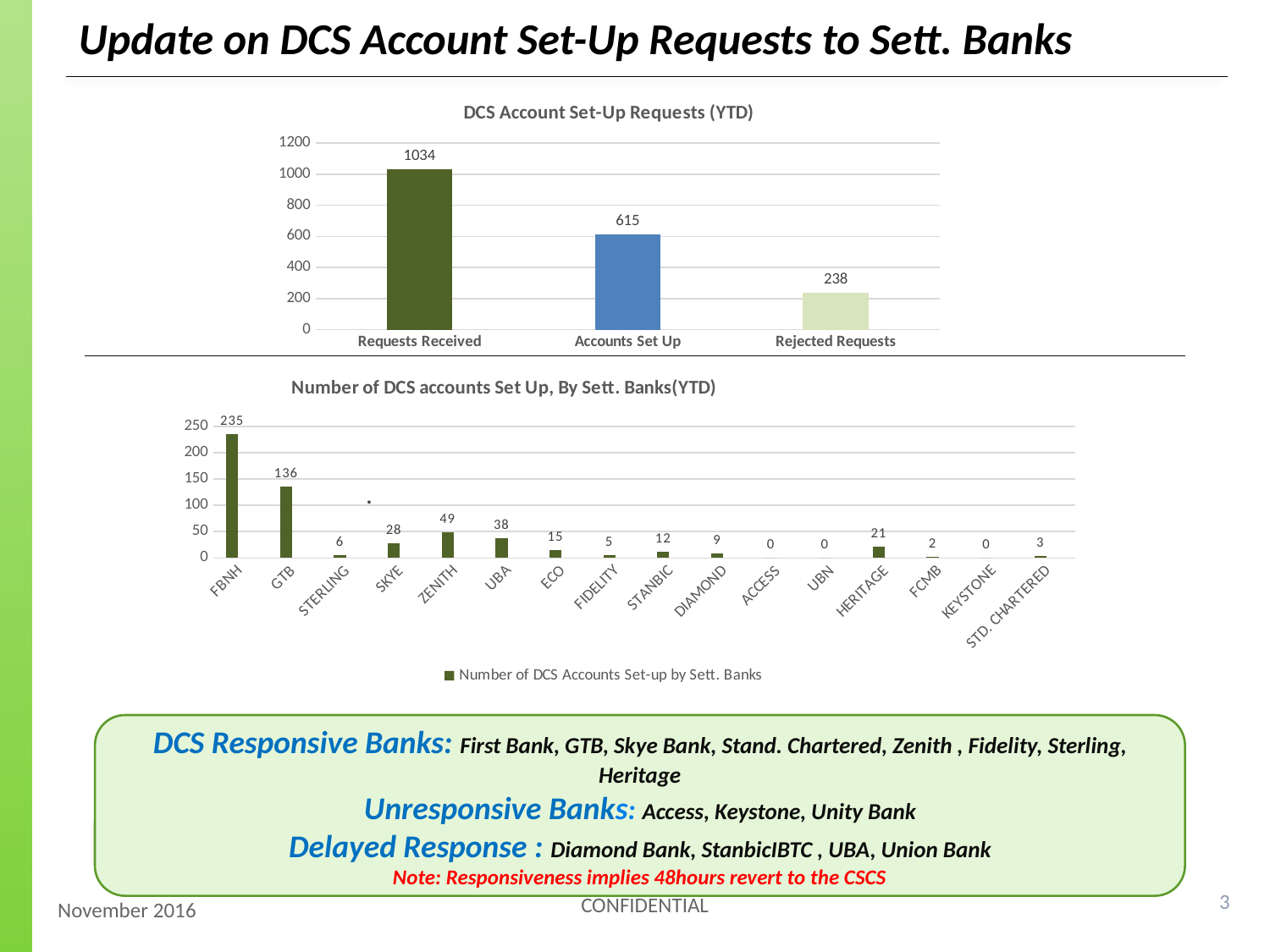
In the 'Number of DCS accounts Set Up, By Sett. Banks(YTD)' chart, how many banks are shown on the x axis? 16 In the 'DCS Account Set-Up Requests (YTD)' chart, which category has the lowest value? Rejected Requests In the 'DCS Account Set-Up Requests (YTD)' chart, what is the difference between Requests Received and Accounts Set Up? 419 What kind of chart is the 'Number of DCS accounts Set Up, By Sett. Banks(YTD)' chart? Bar chart In the 'Number of DCS accounts Set Up, By Sett. Banks(YTD)' chart, what is the value for ZENITH? 49 In the 'DCS Account Set-Up Requests (YTD)' chart, what is the value for Requests Received? 1034 In the 'Number of DCS accounts Set Up, By Sett. Banks(YTD)' chart, how many series does the legend list? 1 In the 'DCS Account Set-Up Requests (YTD)' chart, how many categories are shown? 3 In the 'DCS Account Set-Up Requests (YTD)' chart, what is the value for Rejected Requests? 238 In the 'Number of DCS accounts Set Up, By Sett. Banks(YTD)' chart, which bank has the highest value? FBNH In the 'Number of DCS accounts Set Up, By Sett. Banks(YTD)' chart, which is larger, UBA or SKYE? UBA In the 'Number of DCS accounts Set Up, By Sett. Banks(YTD)' chart, what is the value for HERITAGE? 21